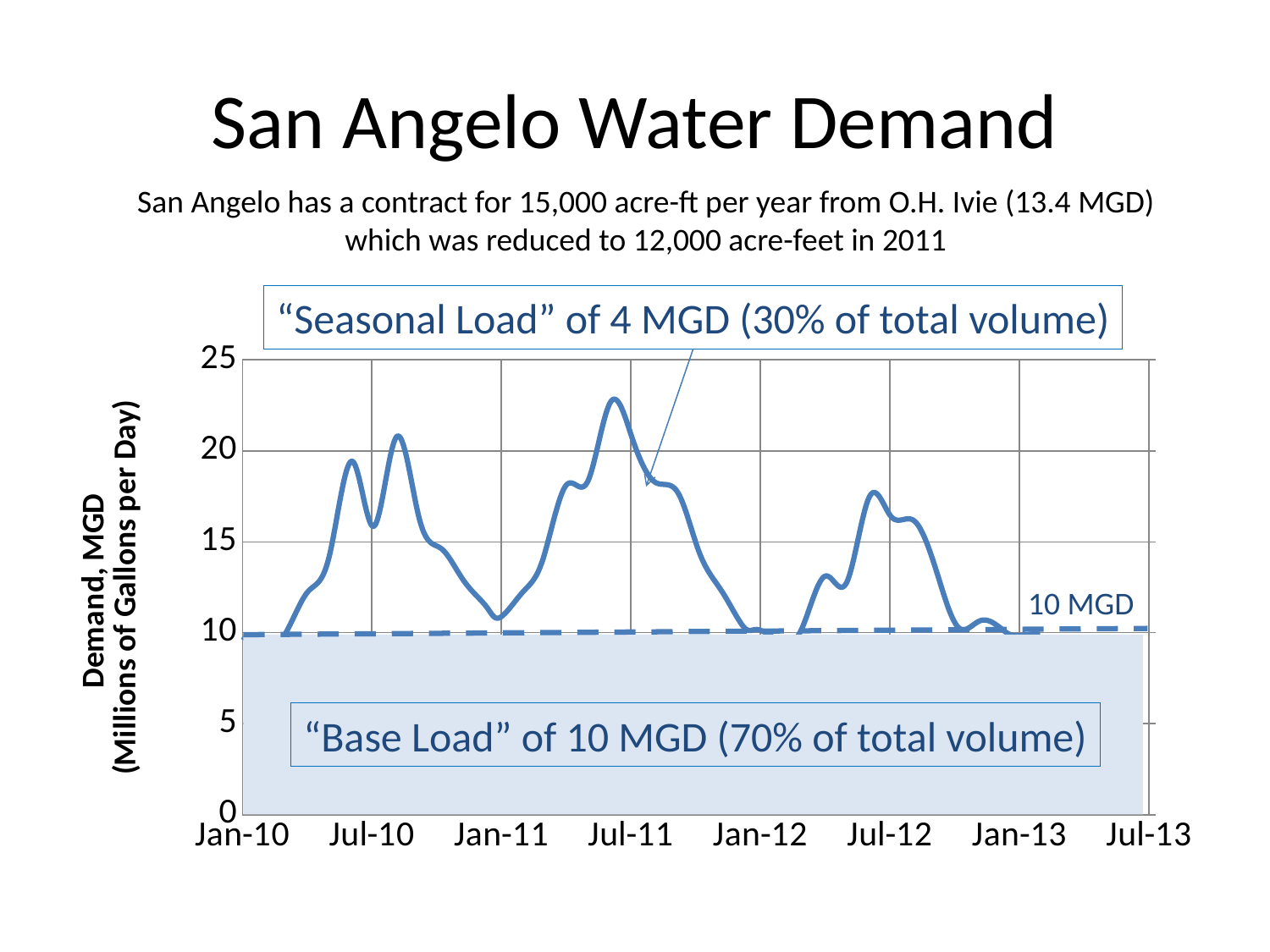
Is the demand at Jan-11 greater or less than 15 MGD? less Which summer had the higher peak demand, 2011 or 2012? 2011 What is the title of the chart on the slide? San Angelo Water Demand What is the label on the vertical axis of the chart? Demand, MGD (Millions of Gallons per Day) Is the peak demand in mid-2011 greater or less than 20 MGD? greater Is the peak demand in mid-2012 greater or less than 20 MGD? less Does demand rise or fall between Jul-11 and Jan-12? fall What kind of chart is shown on the slide? line chart How many tick labels are shown on the horizontal axis? 8 What value does the dashed horizontal line on the chart represent? 10 MGD In which year does the demand line reach its highest peak? 2011